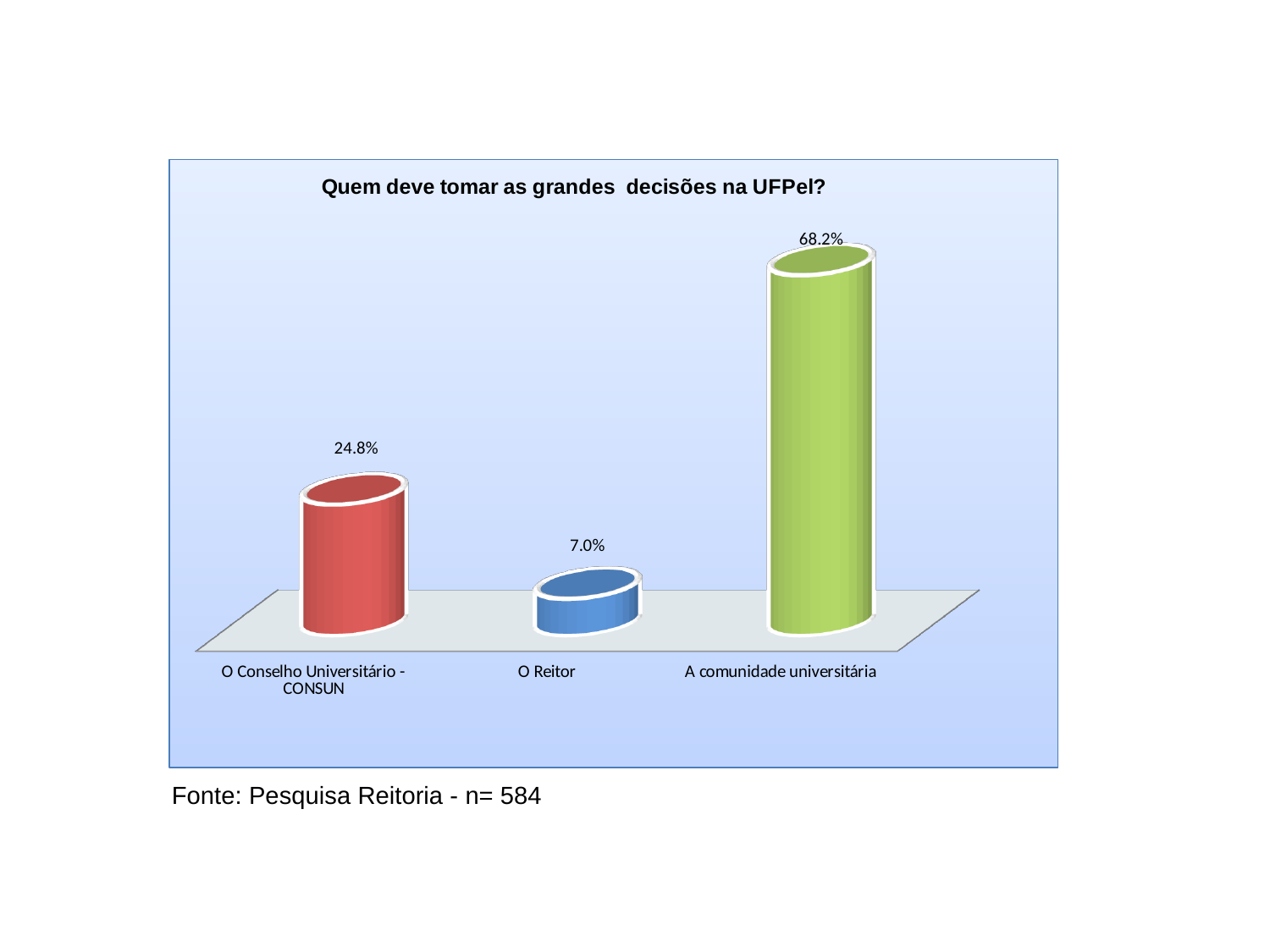
What kind of chart is shown on the slide? Bar chart What is the difference between the values for 'A comunidade universitária' and 'O Conselho Universitário - CONSUN'? 43.4% What is the value for 'O Reitor'? 7.0% What is the difference between the values for 'O Conselho Universitário - CONSUN' and 'O Reitor'? 17.8% Which is larger, the value for 'O Conselho Universitário - CONSUN' or the value for 'O Reitor'? O Conselho Universitário - CONSUN Which category has the highest value? A comunidade universitária What is the value for 'O Conselho Universitário - CONSUN'? 24.8% How many categories are shown in the chart? 3 What is the value for 'A comunidade universitária'? 68.2% What colour is the bar for 'A comunidade universitária'? Green Which category has the lowest value? O Reitor What is the title of the chart? Quem deve tomar as grandes decisões na UFPel?